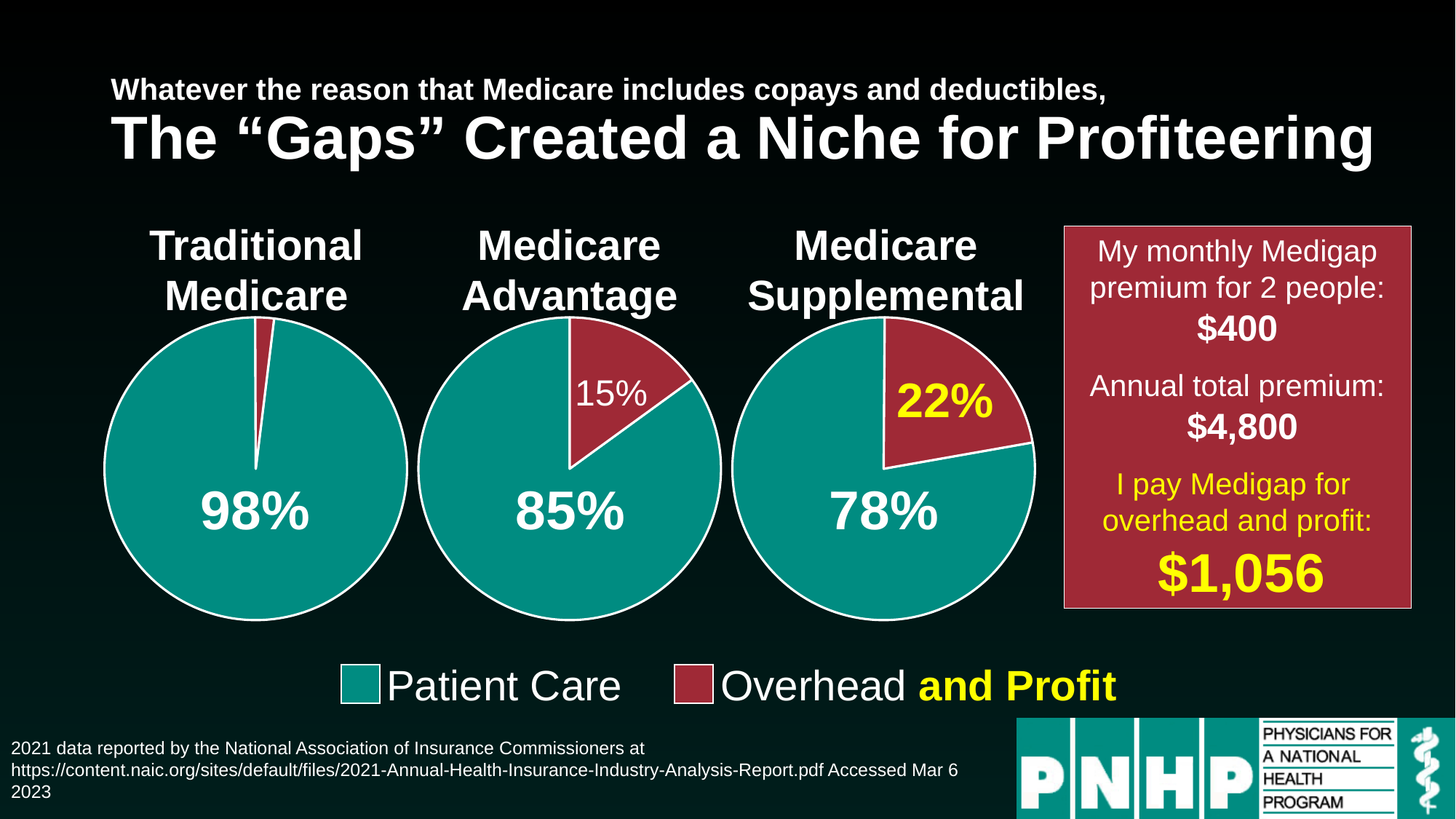
What type of chart is used to show the Patient Care and Overhead and Profit shares? Pie chart What is the difference in Overhead and Profit share between the Medicare Supplemental and Medicare Advantage pie charts? 7% How many entries does the legend list? 2 Is the Patient Care share larger in the Medicare Advantage pie chart or the Medicare Supplemental pie chart? Medicare Advantage How many pie charts are shown on the slide? 3 What is the difference in Patient Care share between the Traditional Medicare and Medicare Supplemental pie charts? 20% In the Medicare Supplemental pie chart, what share goes to Patient Care? 78% In the Medicare Advantage pie chart, what share goes to Overhead and Profit? 15% In the Traditional Medicare pie chart, what share goes to Patient Care? 98% Which of the three pie charts shows the highest Patient Care share? Traditional Medicare Which of the three pie charts shows the lowest Patient Care share? Medicare Supplemental In the Medicare Supplemental pie chart, what share goes to Overhead and Profit? 22%